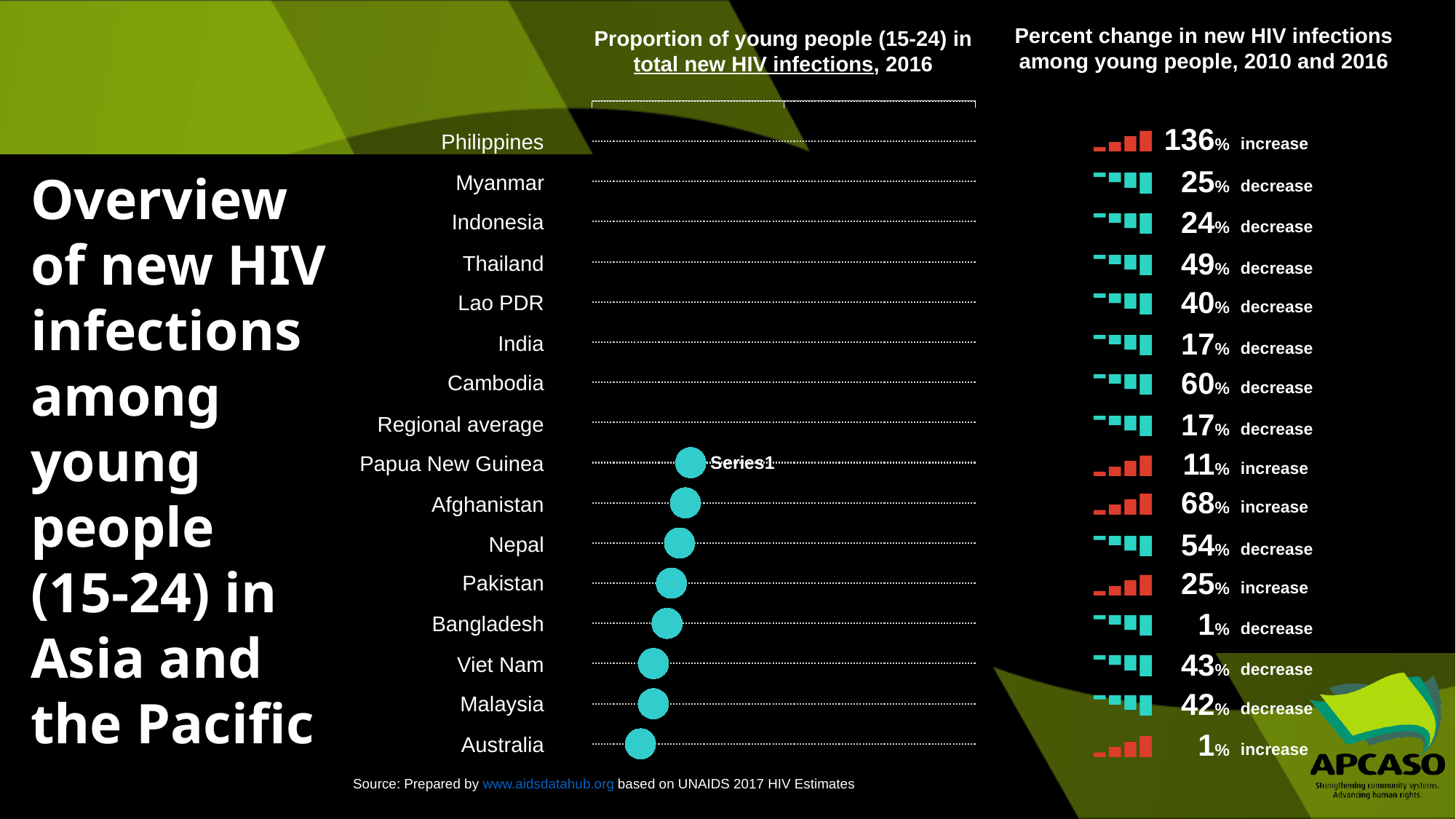
What is the title of the chart in the middle of the slide? Proportion of young people (15-24) in total new HIV infections, 2016 In the 'Percent change in new HIV infections among young people, 2010 and 2016' panel, what is the difference between the percent decrease for Thailand and for Lao PDR? 9% What series name is shown as a label on the 'Proportion of young people (15-24) in total new HIV infections, 2016' chart? Series1 In the 'Percent change in new HIV infections among young people, 2010 and 2016' panel, how many countries show an increase? 5 What kind of chart is the 'Proportion of young people (15-24) in total new HIV infections, 2016' chart? Dot plot (scatter chart) In the 'Percent change in new HIV infections among young people, 2010 and 2016' panel, which country shows the largest percent increase? Philippines How many categories are listed on the 'Proportion of young people (15-24) in total new HIV infections, 2016' chart? 16 In the 'Percent change in new HIV infections among young people, 2010 and 2016' panel, what is the value for the Regional average? 17% decrease In the 'Percent change in new HIV infections among young people, 2010 and 2016' panel, which country shows the largest percent decrease? Cambodia In the 'Percent change in new HIV infections among young people, 2010 and 2016' panel, what is the value for Afghanistan? 68% increase In the 'Percent change in new HIV infections among young people, 2010 and 2016' panel, what is the value for the Philippines? 136% increase In the 'Percent change in new HIV infections among young people, 2010 and 2016' panel, what is the value for Cambodia? 60% decrease